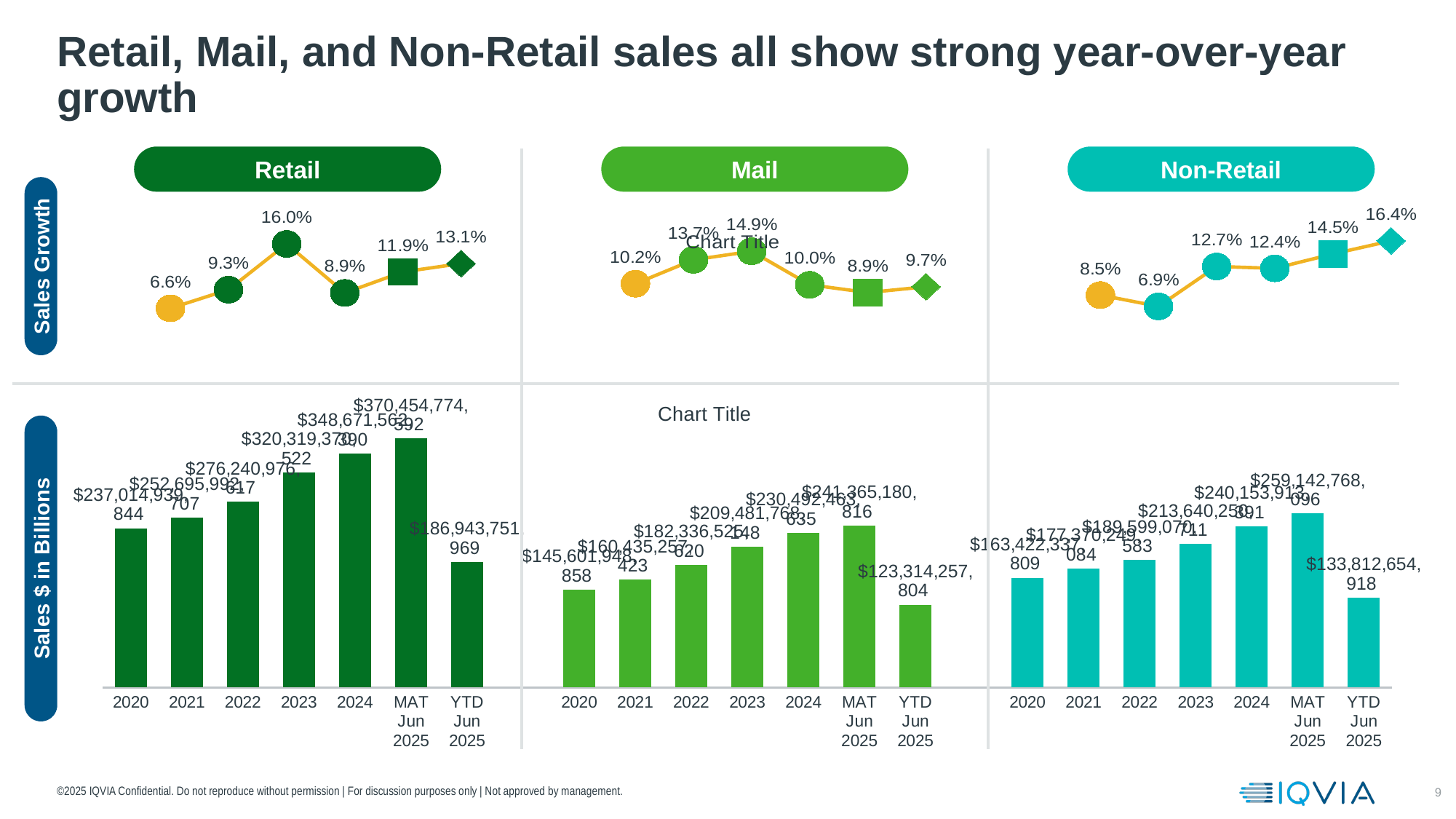
In the Mail Sales Growth line chart, what is the lowest growth value shown? 8.9% In the Retail Sales $ bar chart, what is the value for YTD Jun 2025? $186,943,751,969 How many categories are shown on the x axis of the Non-Retail Sales $ bar chart? 7 In the Retail Sales $ bar chart, which category has the tallest bar? MAT Jun 2025 In the Mail Sales $ bar chart, what is the value for YTD Jun 2025? $123,314,257,804 In the Non-Retail Sales $ bar chart, what is the value for YTD Jun 2025? $133,812,654,918 In the Non-Retail Sales Growth line chart, what is the highest growth value shown? 16.4% In the Retail Sales $ bar chart, what is the value for 2020? $237,014,939,844 In the Retail Sales Growth line chart, what is the highest growth value shown? 16.0% How many data points are plotted in the Retail Sales Growth line chart? 6 In the Mail Sales $ bar chart, which category has the shortest bar? YTD Jun 2025 In the Non-Retail Sales $ bar chart, do the values rise or fall from 2020 to 2024? rise